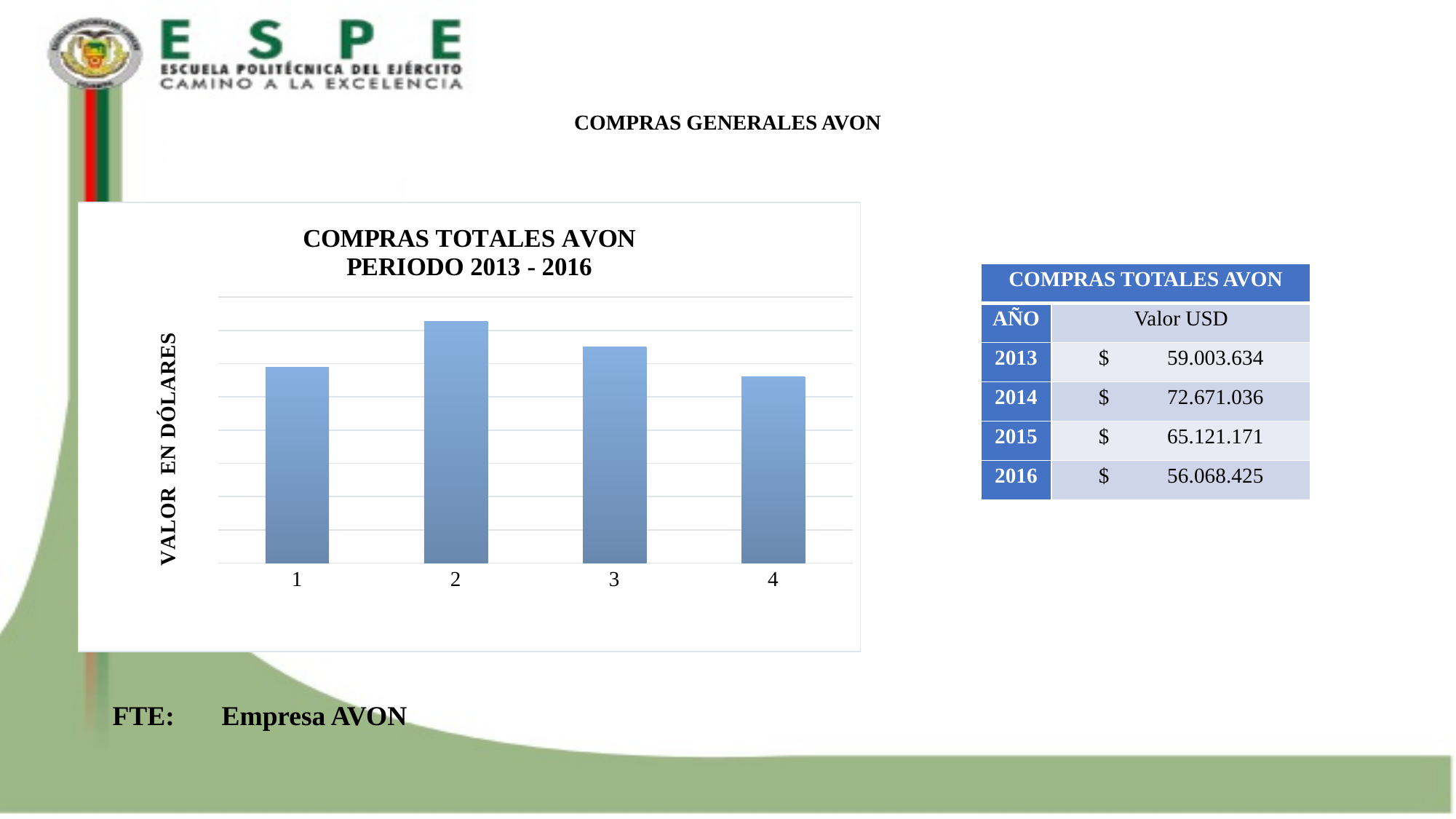
What is the title of the chart? COMPRAS TOTALES AVON PERIODO 2013 - 2016 Is the bar for category 1 taller or shorter than the bar for category 3? shorter How many bars does the chart show? 4 Which category has the shortest bar in the chart? 4 What is the label on the vertical axis of the chart? VALOR EN DÓLARES Do the bar values rise or fall from category 2 to category 4? fall What kind of chart is shown on the slide? bar chart Which category has the tallest bar in the chart? 2 According to the table next to the chart, which year has the highest value? 2014 According to the table next to the chart, what is the value in USD for 2016? $ 56.068.425 According to the table next to the chart, what is the value in USD for 2014? $ 72.671.036 Is the bar for category 2 taller or shorter than the bar for category 4? taller